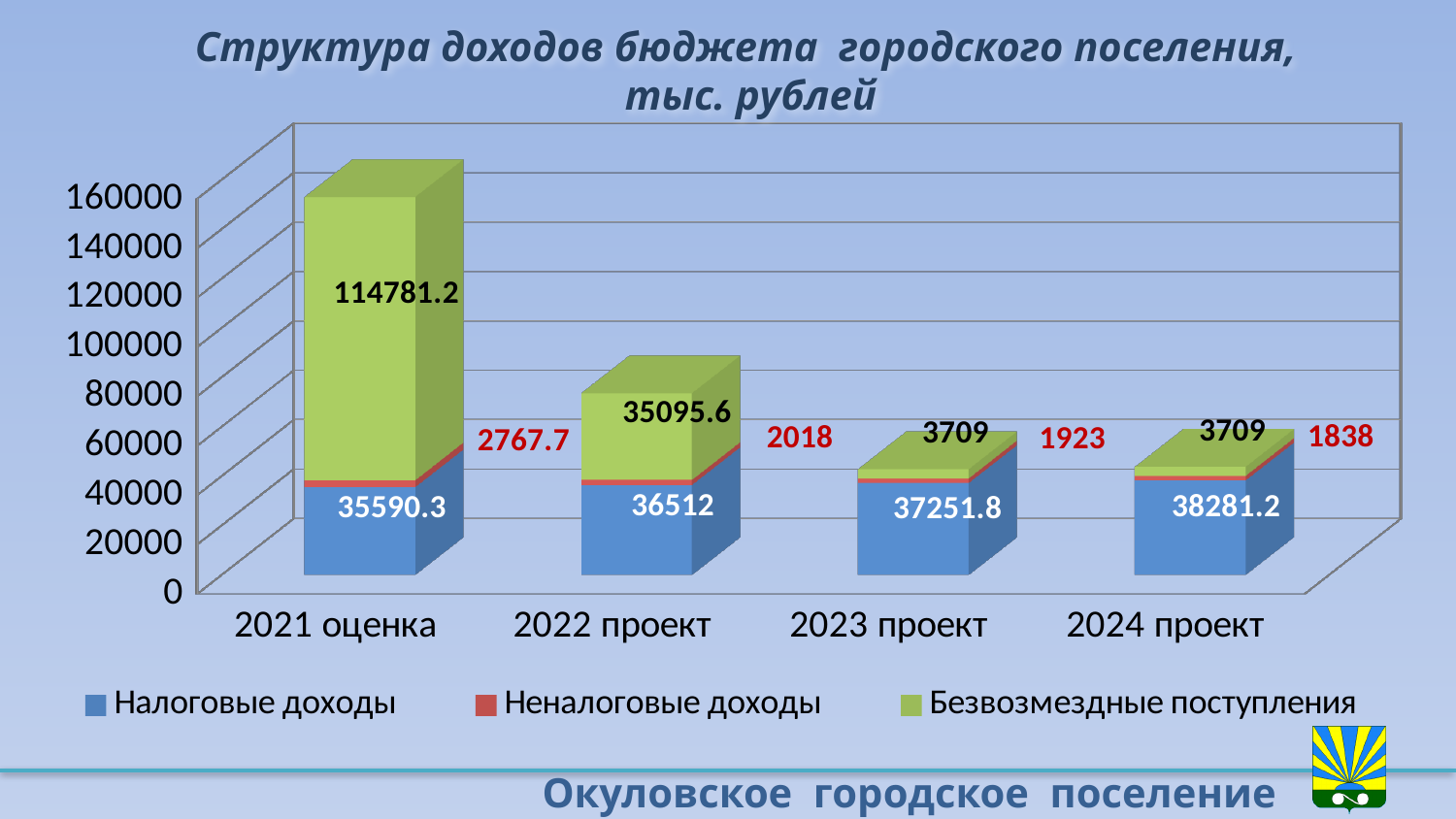
How many series does the legend list? 3 What kind of chart is shown on the slide? Stacked bar chart What is the value of Налоговые доходы for 2021 оценка? 35590.3 Do the values of Налоговые доходы rise or fall from 2021 оценка to 2024 проект? Rise What is the value of Безвозмездные поступления for 2022 проект? 35095.6 Which is larger: Налоговые доходы for 2022 проект or for 2023 проект? 2023 проект What is the difference between Налоговые доходы for 2024 проект and 2021 оценка? 2690.9 How many categories are shown on the x axis? 4 Which category has the highest value of Безвозмездные поступления? 2021 оценка Which category has the lowest value of Неналоговые доходы? 2024 проект What is the value of Неналоговые доходы for 2023 проект? 1923 What is the total of the stacked bar for 2023 проект? 42883.8